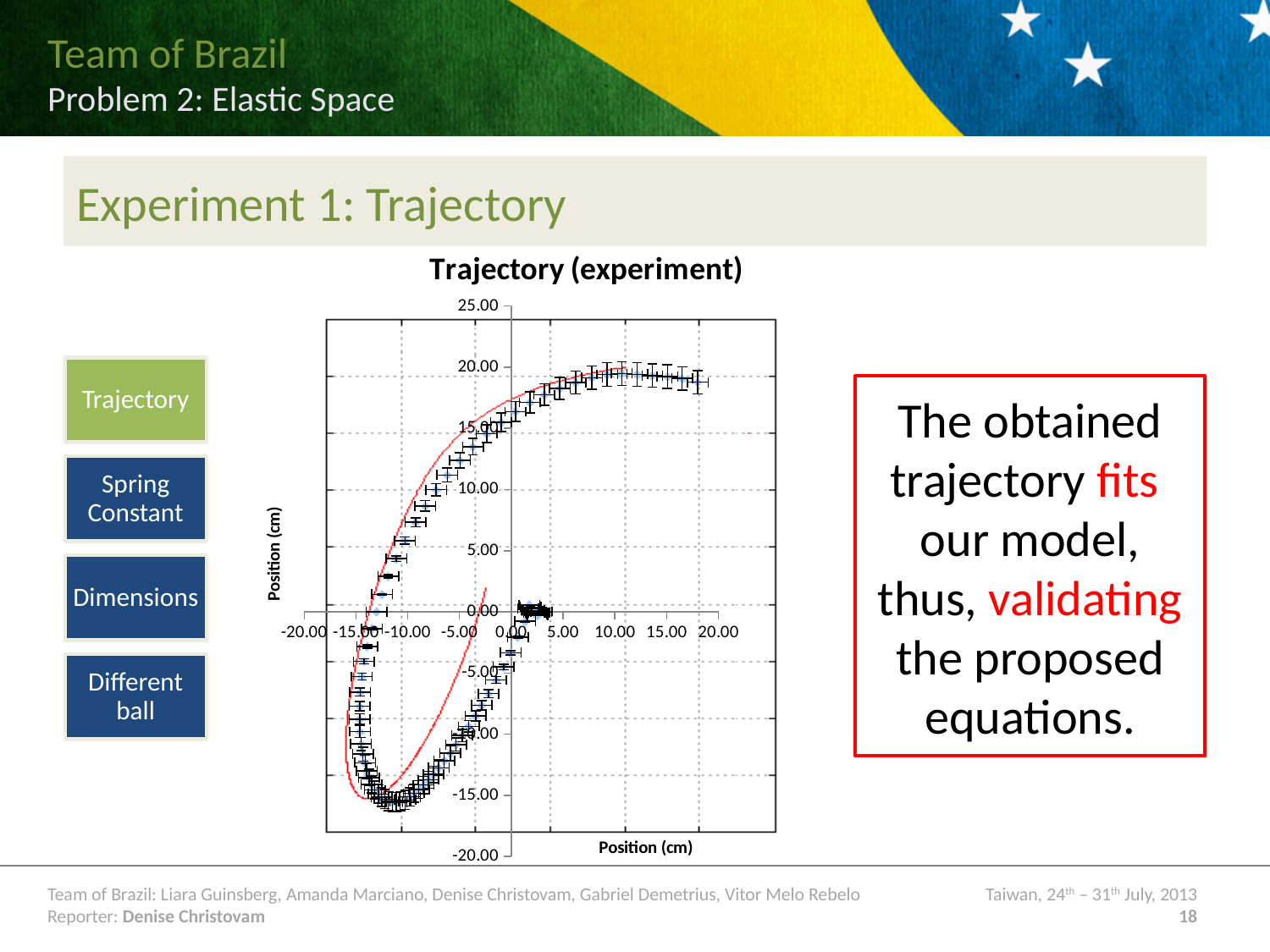
Is the highest vertical position reached by the data points greater or less than 25.00? less Is the leftmost horizontal position reached by the data points greater or less than -10.00? less What is the label of the vertical axis of the chart? Position (cm) Is the lowest vertical position reached by the data points greater or less than -10.00? less What is the title of the chart? Trajectory (experiment) What kind of chart is shown on the slide? scatter chart